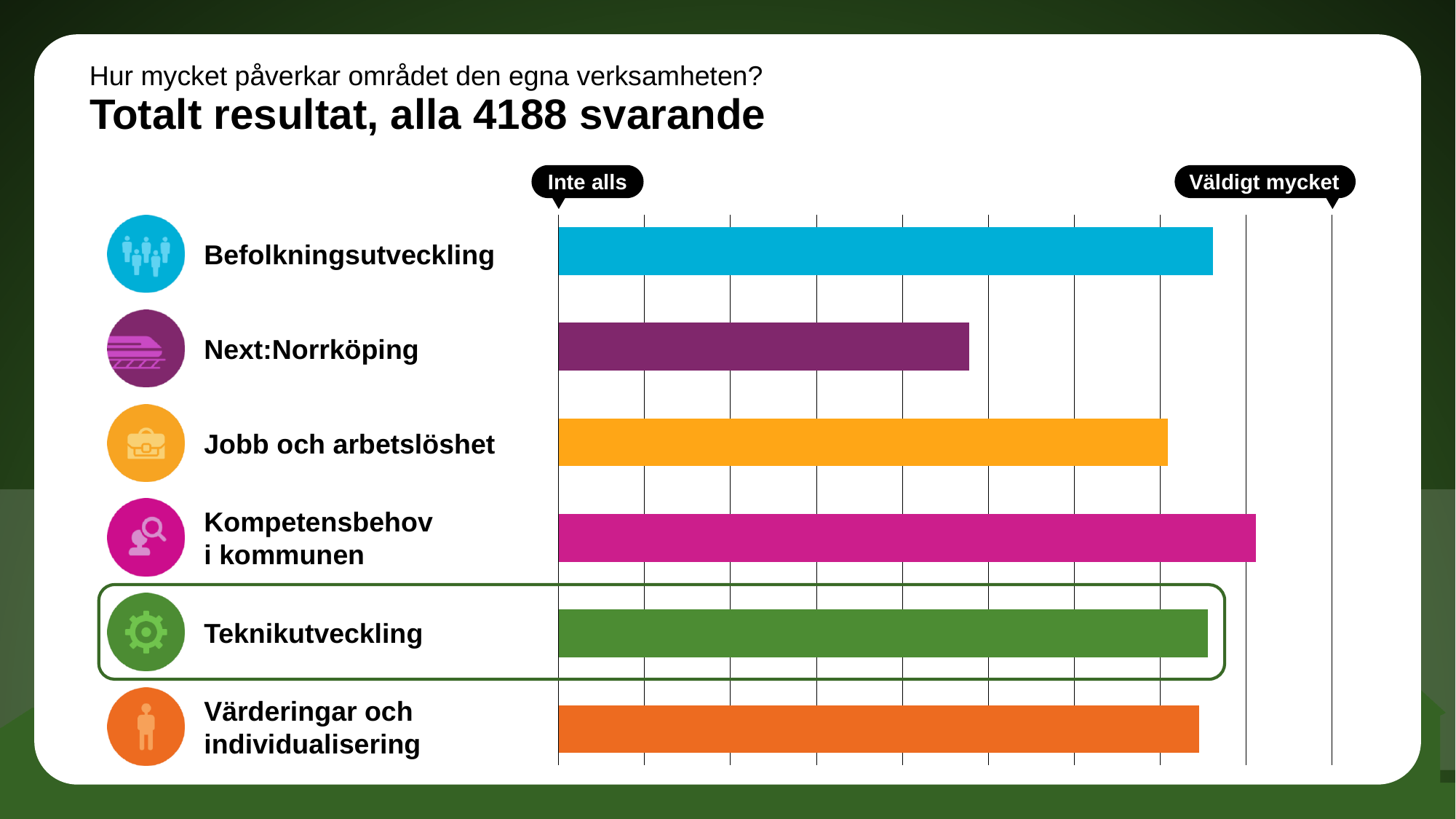
Which bar is longer, Kompetensbehov i kommunen or Jobb och arbetslöshet? Kompetensbehov i kommunen Which bar is longer, Next:Norrköping or Teknikutveckling? Teknikutveckling What are the two labels at the ends of the chart's horizontal axis? Inte alls and Väldigt mycket How many categories (areas) are shown in the chart? 6 What kind of chart is shown on the slide? bar chart Which bar is longer, Kompetensbehov i kommunen or Värderingar och individualisering? Kompetensbehov i kommunen What is the title of the chart on the slide? Totalt resultat, alla 4188 svarande Which area has the longest bar in the chart? Kompetensbehov i kommunen Which area has the shortest bar in the chart? Next:Norrköping